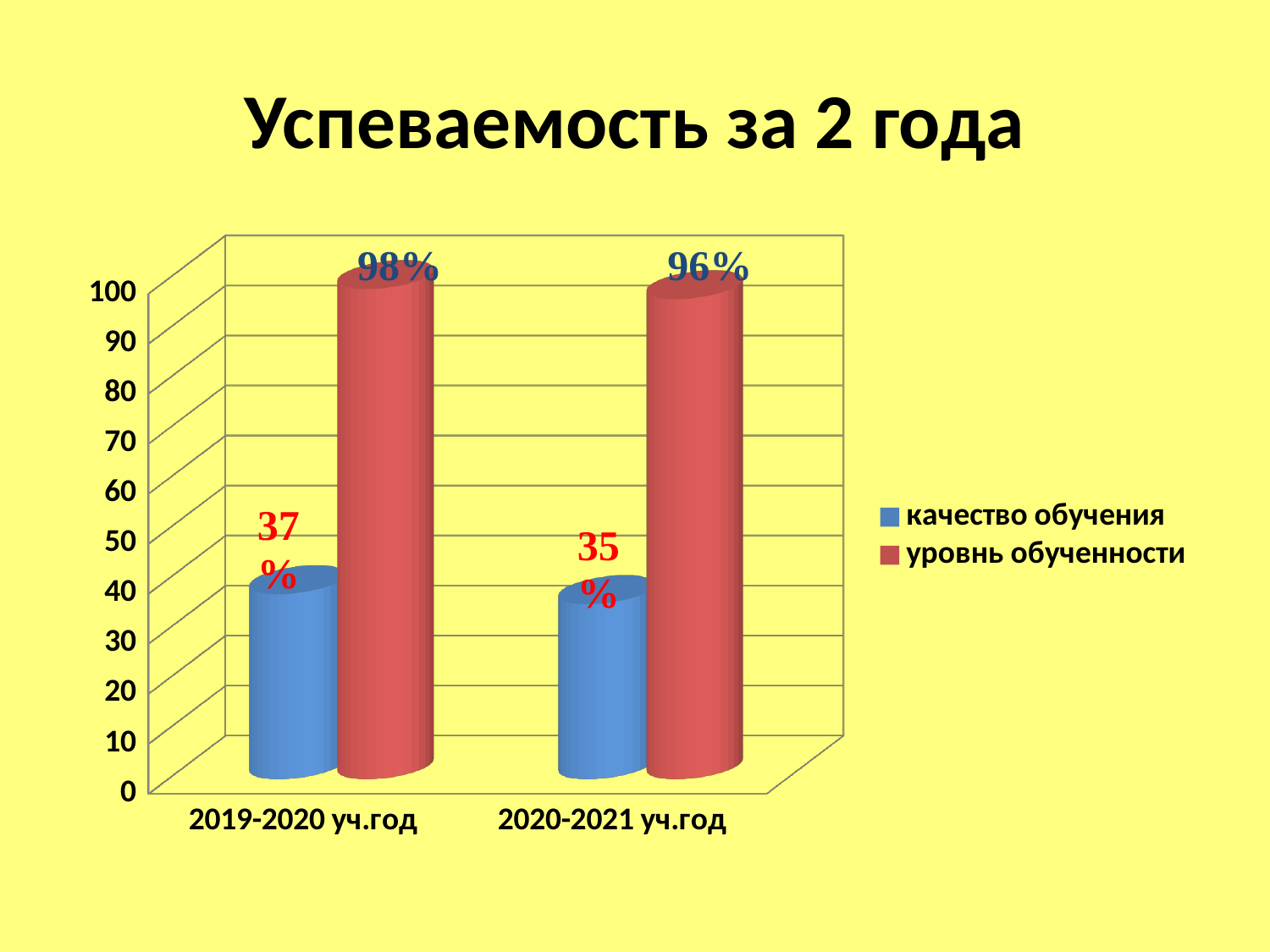
What is the value of качество обучения for 2019-2020 уч.год? 37% Which is larger in 2020-2021 уч.год: качество обучения or уровнь обученности? уровнь обученности What is the value of уровнь обученности for 2019-2020 уч.год? 98% What is the value of уровнь обученности for 2020-2021 уч.год? 96% What is the difference between уровнь обученности and качество обучения in 2019-2020 уч.год? 61% What is the value of качество обучения for 2020-2021 уч.год? 35% How many series does the legend list? 2 In which year is качество обучения lowest? 2020-2021 уч.год By how much did качество обучения change from 2019-2020 уч.год to 2020-2021 уч.год? 2% In which year is уровнь обученности highest? 2019-2020 уч.год What type of chart is shown on the slide? Bar chart How many categories (school years) are shown on the x axis? 2